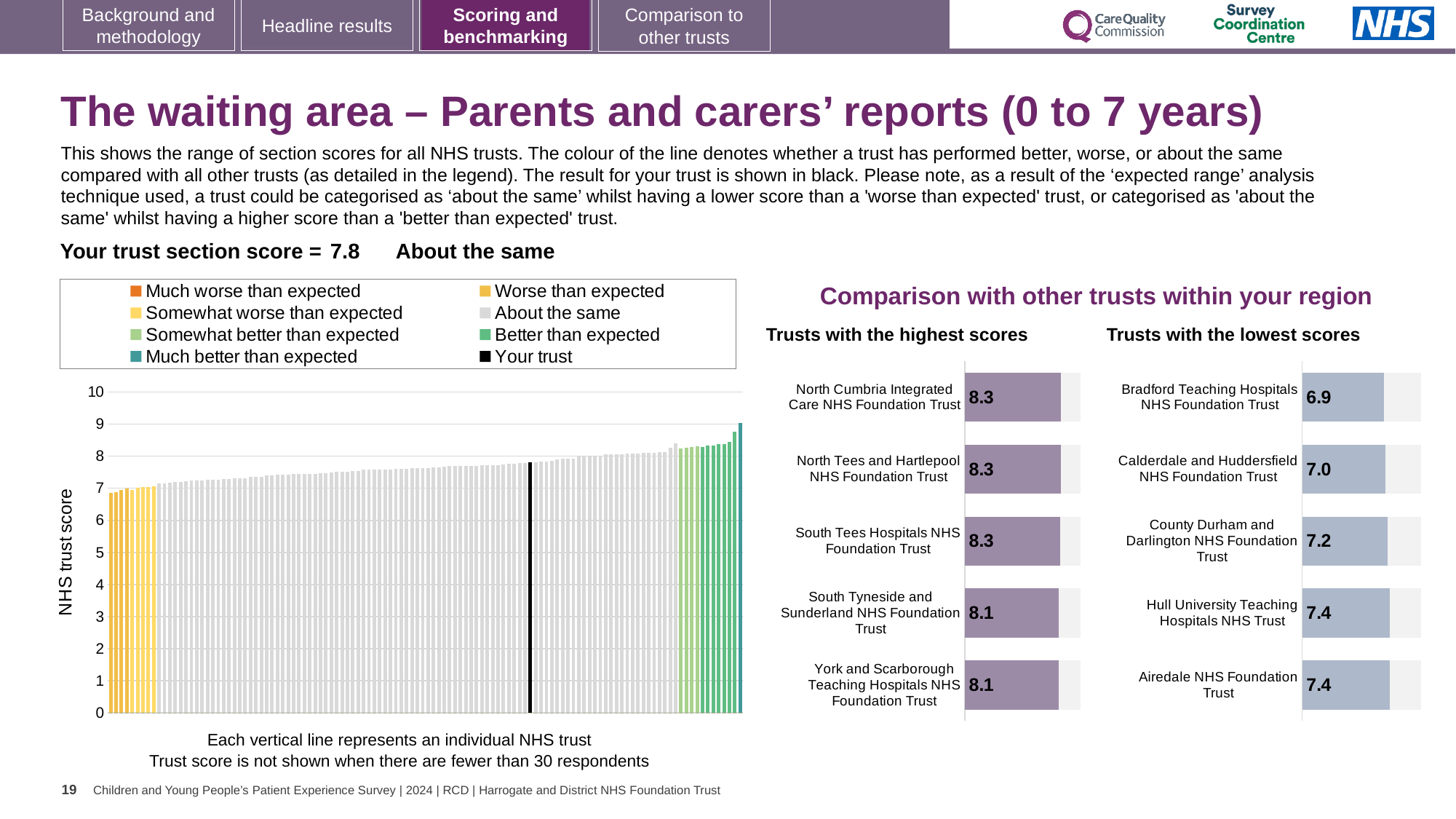
In the main chart of all NHS trusts on the left, is the value for the black 'Your trust' bar greater or less than 7? greater In the 'Trusts with the highest scores' chart, what is the difference between the scores of South Tees Hospitals NHS Foundation Trust and South Tyneside and Sunderland NHS Foundation Trust? 0.2 How many trusts are listed in the 'Trusts with the highest scores' chart? 5 In the 'Trusts with the lowest scores' chart, which trust has the lowest score? Bradford Teaching Hospitals NHS Foundation Trust How many entries does the legend above the main chart of all NHS trusts list? 8 In the 'Trusts with the lowest scores' chart, what is the score for Calderdale and Huddersfield NHS Foundation Trust? 7.0 In the 'Trusts with the highest scores' chart, what is the score for North Cumbria Integrated Care NHS Foundation Trust? 8.3 In the main chart of all NHS trusts on the left, do the trust scores rise or fall from left to right? Rise In the 'Trusts with the lowest scores' chart, which has the higher score: Calderdale and Huddersfield NHS Foundation Trust or County Durham and Darlington NHS Foundation Trust? County Durham and Darlington NHS Foundation Trust In the 'Trusts with the lowest scores' chart, what is the difference between the scores of Hull University Teaching Hospitals NHS Trust and Bradford Teaching Hospitals NHS Foundation Trust? 0.5 What kind of chart is the main chart of all NHS trusts on the left of the slide? Bar chart In the 'Trusts with the highest scores' chart, what is the score for York and Scarborough Teaching Hospitals NHS Foundation Trust? 8.1